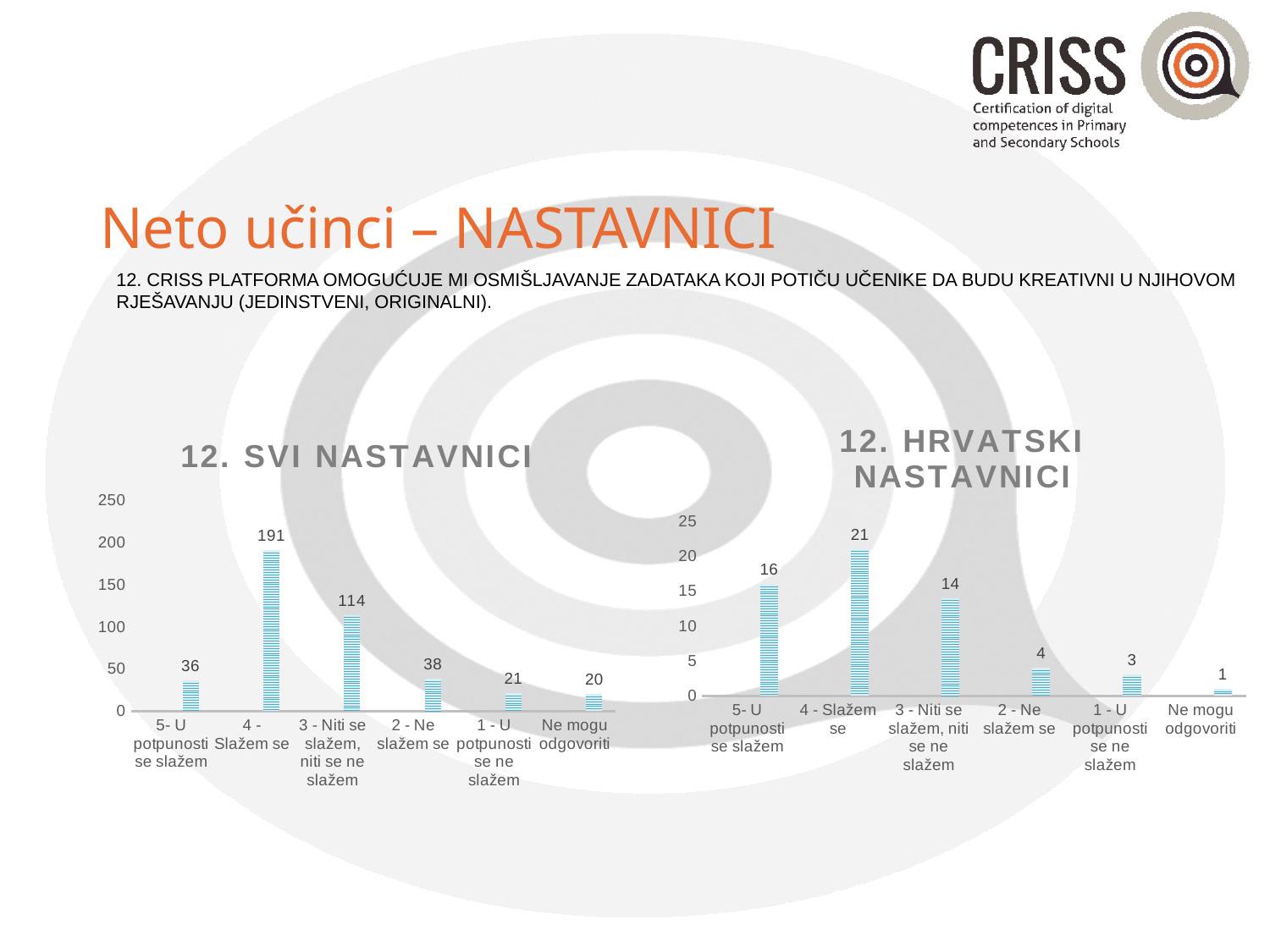
What type of chart is the '12. HRVATSKI NASTAVNICI' chart? Bar chart In the '12. HRVATSKI NASTAVNICI' chart, do the values rise or fall from '3 - Niti se slažem, niti se ne slažem' to 'Ne mogu odgovoriti'? Fall In the '12. HRVATSKI NASTAVNICI' chart, which category has the highest value? 4 - Slažem se In the '12. HRVATSKI NASTAVNICI' chart, what is the difference between '4 - Slažem se' and '3 - Niti se slažem, niti se ne slažem'? 7 In the '12. SVI NASTAVNICI' chart, what is the value for '4 - Slažem se'? 191 In the '12. SVI NASTAVNICI' chart, which is larger: '5- U potpunosti se slažem' or '2 - Ne slažem se'? 2 - Ne slažem se In the '12. HRVATSKI NASTAVNICI' chart, what is the value for '5- U potpunosti se slažem'? 16 In the '12. SVI NASTAVNICI' chart, what is the value for '3 - Niti se slažem, niti se ne slažem'? 114 How many categories are shown in the '12. SVI NASTAVNICI' chart? 6 In the '12. SVI NASTAVNICI' chart, which category has the lowest value? Ne mogu odgovoriti In the '12. HRVATSKI NASTAVNICI' chart, what is the value for 'Ne mogu odgovoriti'? 1 In the '12. SVI NASTAVNICI' chart, what is the difference between '4 - Slažem se' and '3 - Niti se slažem, niti se ne slažem'? 77